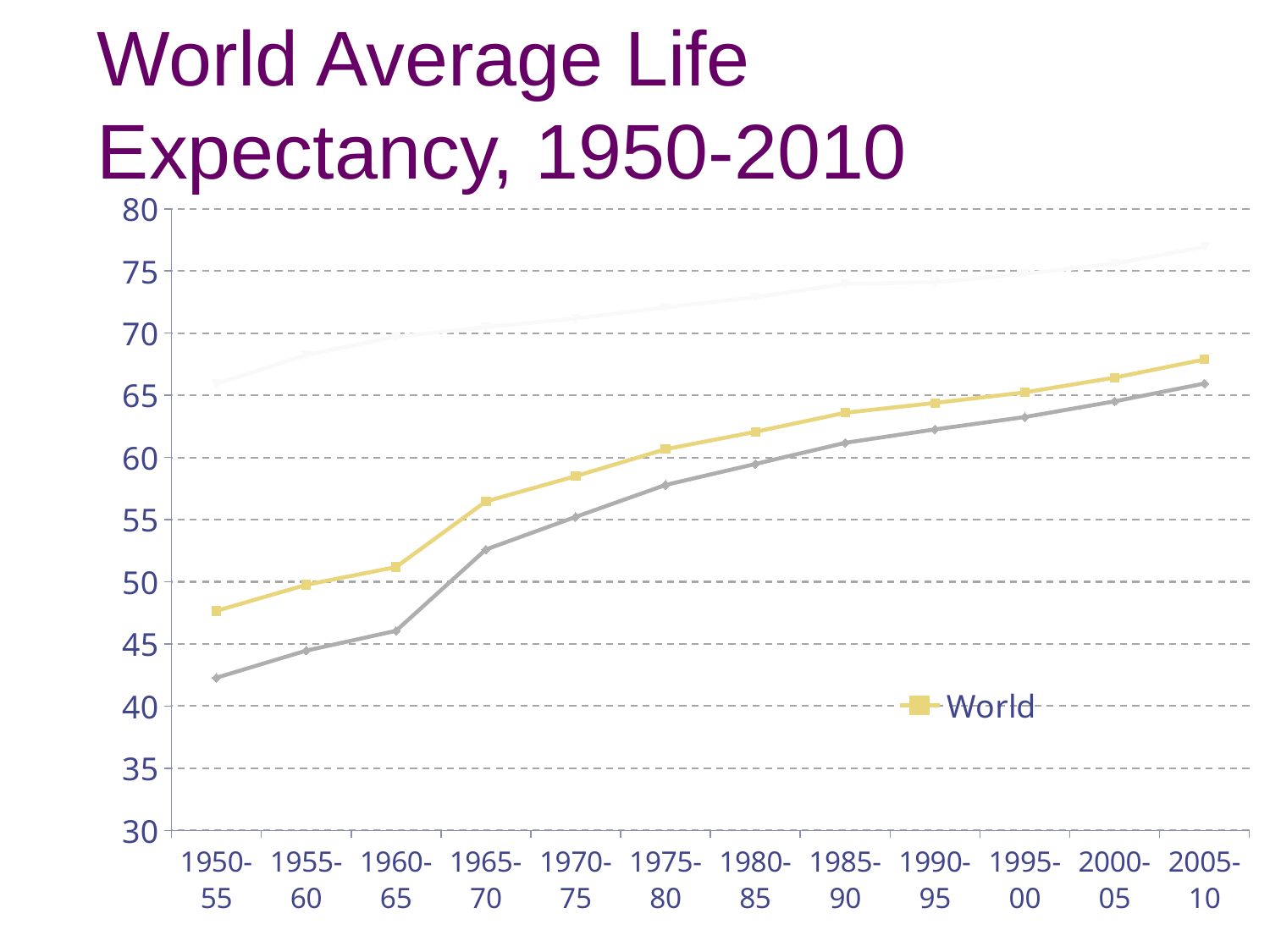
What is the title of the chart? World Average Life Expectancy, 1950-2010 Is the World value for 1970-75 greater or less than 60? less How many time periods are shown along the x axis? 12 Is the World value for 2005-10 greater or less than 65? greater What series name appears in the legend? World What kind of chart is shown on the slide? line chart In which period is the World value highest? 2005-10 How many series does the legend list? 1 Is the World value for 1950-55 greater or less than 50? less Does the World line rise or fall from 1950-55 to 2005-10? rise In which period is the World value lowest? 1950-55